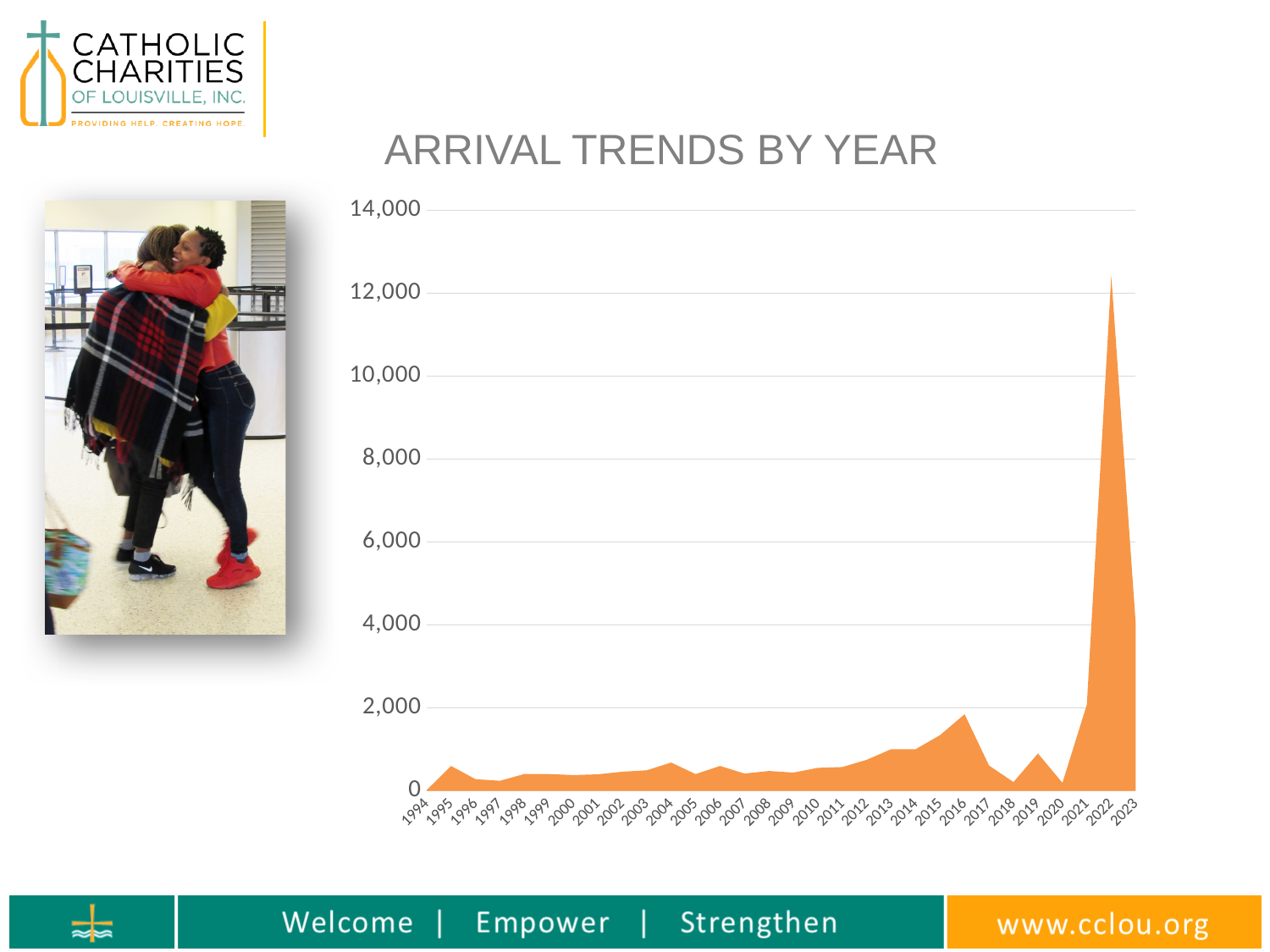
How many years are shown on the x axis of the chart? 30 Do the values rise or fall from 2020 to 2022? rise What is the title of the chart? ARRIVAL TRENDS BY YEAR Which year has the lowest value in the chart? 1994 Which year has the larger value, 2016 or 2018? 2016 What kind of chart is shown on the slide? area chart What colour is the area in the chart? orange Is the value for 2022 greater or less than 12,000? greater Which year has the larger value, 2022 or 2023? 2022 Which year has the highest value in the chart? 2022 Is the value for 2016 greater or less than 2,000? less Is the value for 2020 greater or less than 2,000? less